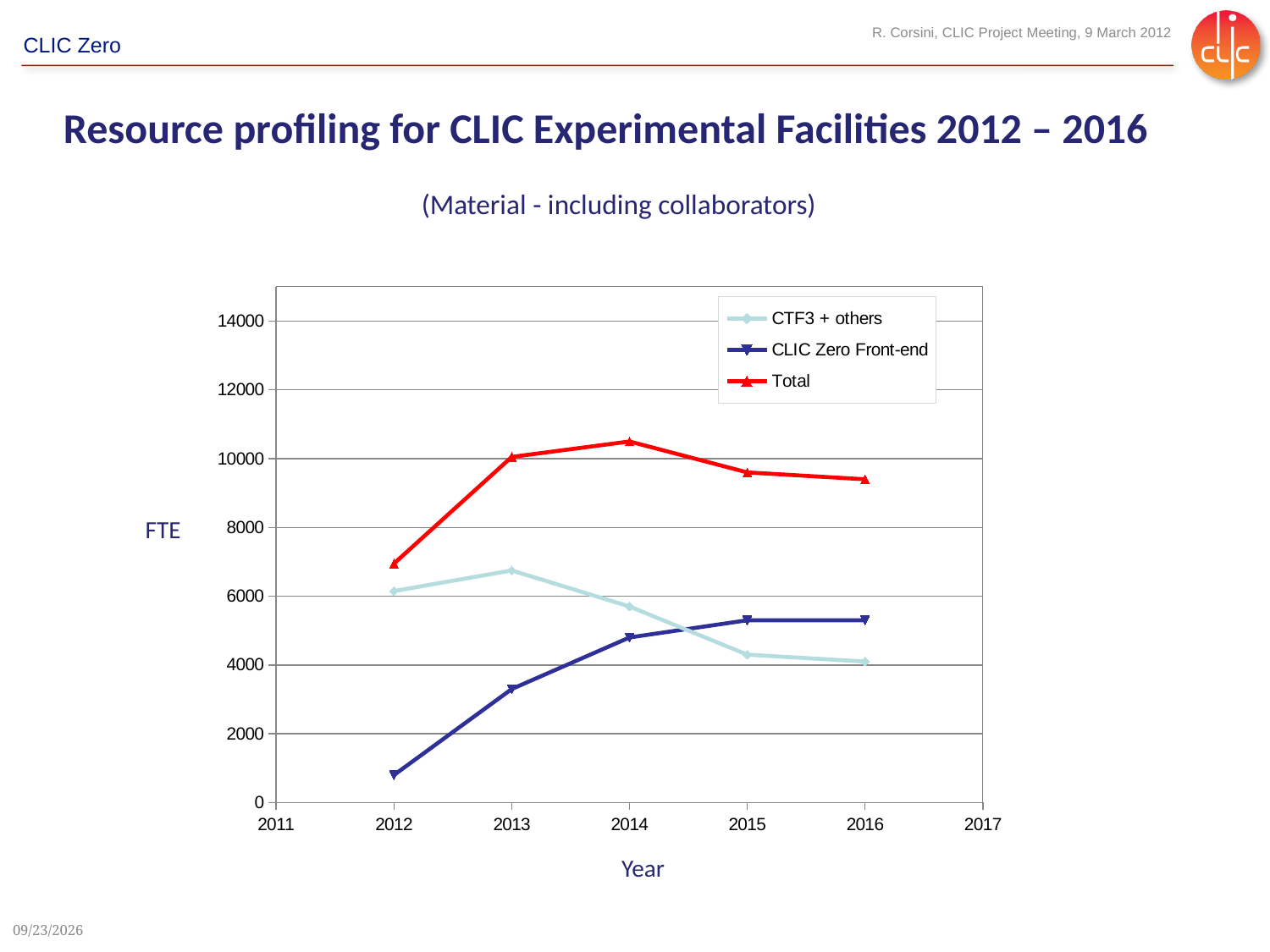
In which year is the CLIC Zero Front-end series at its lowest value? 2012 How many years have plotted data points for the Total series? 5 Is the value for CTF3 + others in 2016 greater or less than 6000? less In 2016, which series has the larger value: CTF3 + others or CLIC Zero Front-end? CLIC Zero Front-end Is the value for CLIC Zero Front-end in 2012 greater or less than 2000? less In which year is the Total series at its lowest value? 2012 Is the value for Total in 2014 greater or less than 10000? greater What kind of chart is shown on the slide? line chart How many series does the legend list? 3 What is the label on the vertical axis of the chart? FTE In which year does the Total series reach its highest value? 2014 Does the CLIC Zero Front-end series rise or fall from 2012 to 2015? rise